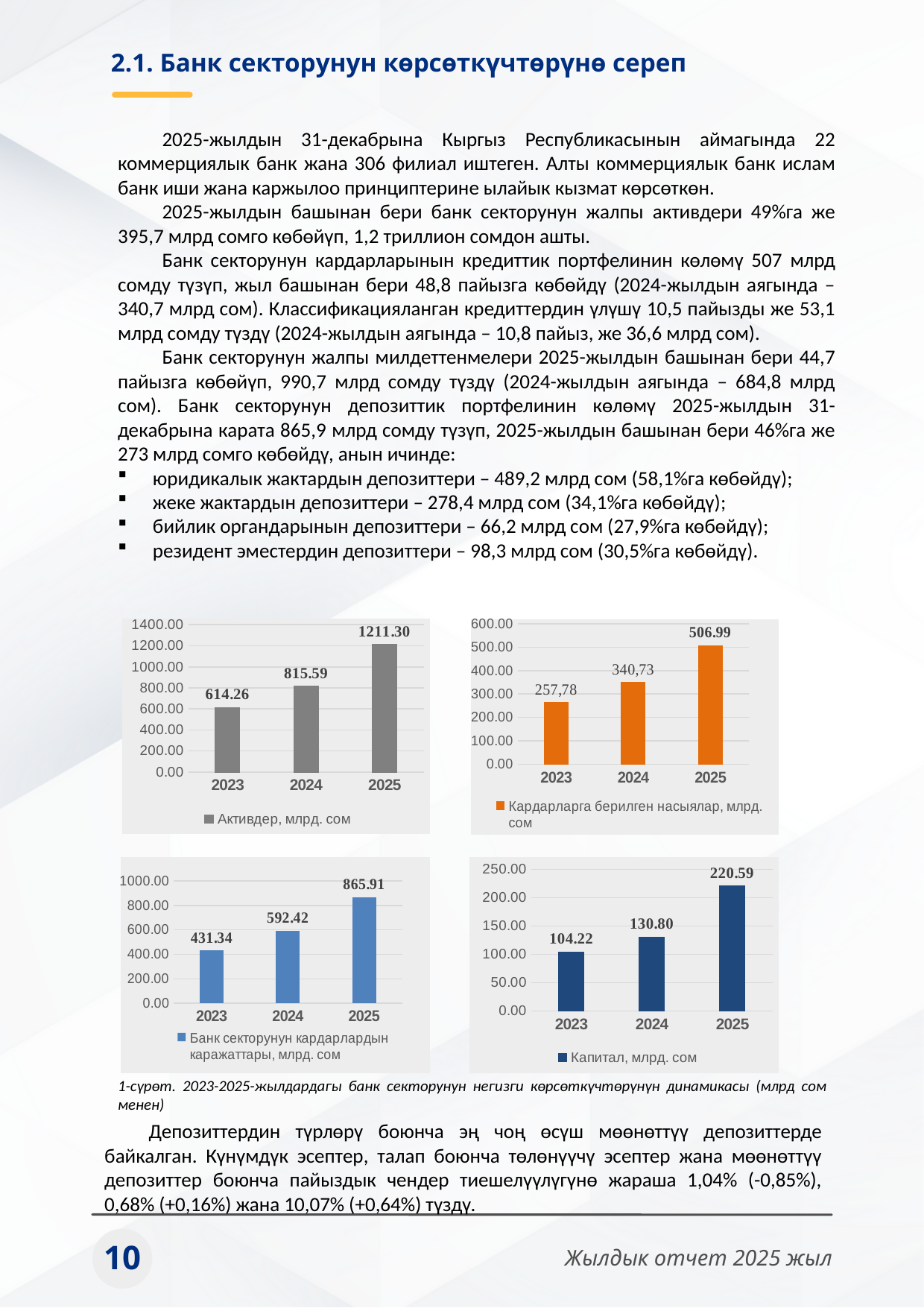
In the 'Активдер, млрд. сом' chart, what is the difference between the 2025 and 2024 values? 395.71 In the 'Капитал, млрд. сом' chart, what is the difference between the 2025 and 2023 values? 116.37 What type of chart is the 'Активдер, млрд. сом' chart? bar chart In the 'Банк секторунун кардарлардын каражаттары, млрд. сом' chart, what is the value for 2024? 592.42 In the 'Активдер, млрд. сом' chart, what is the value for 2025? 1211.30 In the 'Кардарларга берилген насыялар, млрд. сом' chart, which is larger: the value for 2024 or the value for 2025? 2025 How many years are shown on the x axis of the 'Капитал, млрд. сом' chart? 3 In the 'Банк секторунун кардарлардын каражаттары, млрд. сом' chart, do the values rise or fall from 2023 to 2025? rise In the 'Капитал, млрд. сом' chart, which year has the highest value? 2025 In the 'Активдер, млрд. сом' chart, which year has the lowest value? 2023 In the 'Капитал, млрд. сом' chart, what is the value for 2023? 104.22 In the 'Кардарларга берилген насыялар, млрд. сом' chart, what is the value for 2023? 257,78